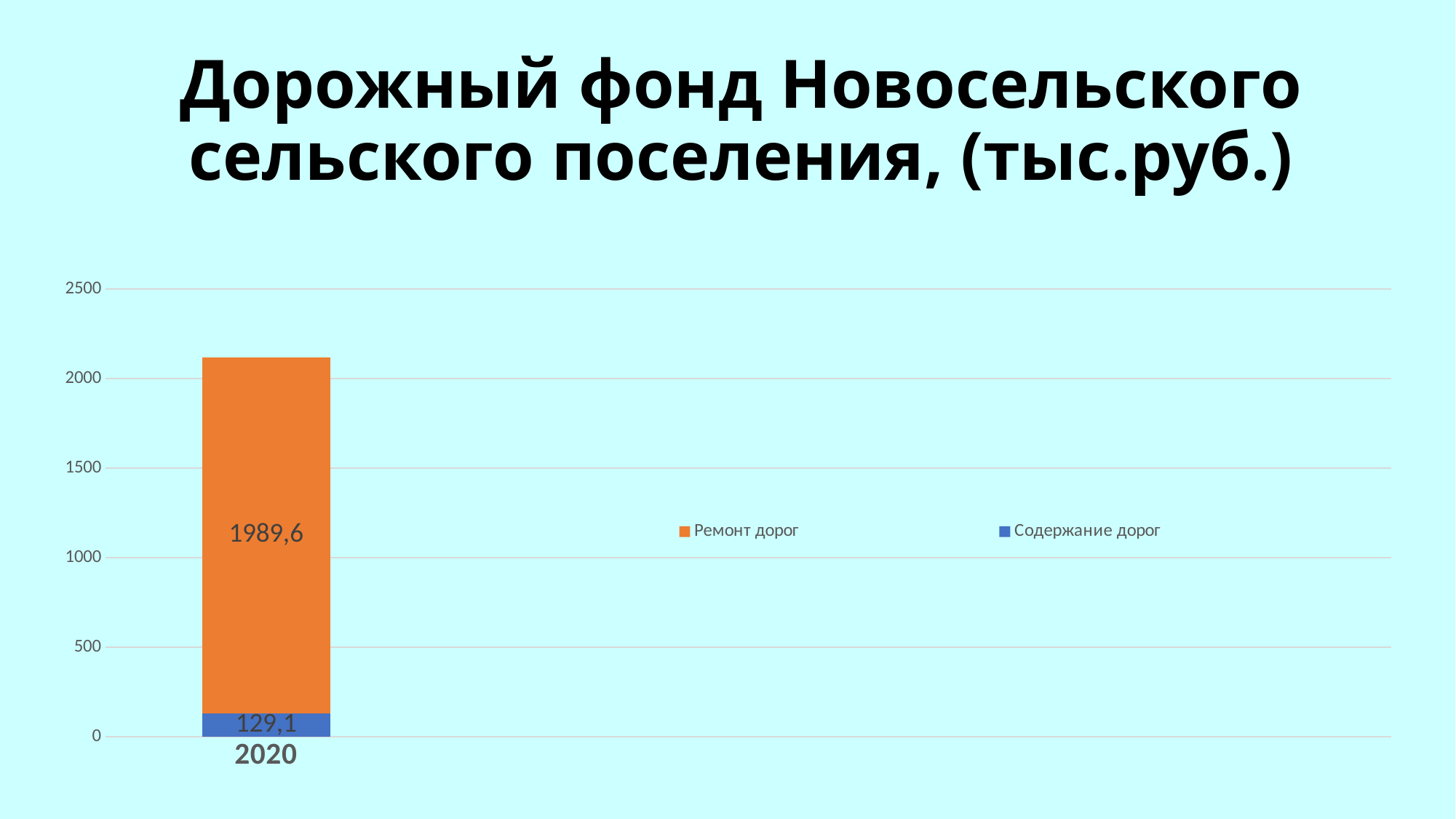
Is the total height of the 2020 stacked bar greater or less than 2000? greater What is the value for Содержание дорог in 2020? 129,1 Which series has the larger value in 2020, Ремонт дорог or Содержание дорог? Ремонт дорог Is the value for Содержание дорог in 2020 greater or less than 500? less What is the total of the stacked bar for 2020? 2118,7 What is the value for Ремонт дорог in 2020? 1989,6 What is the difference between the Ремонт дорог and Содержание дорог values in 2020? 1860,5 How many series does the legend list? 2 What kind of chart is shown on the slide? Stacked bar chart What is the title of the chart? Дорожный фонд Новосельского сельского поселения, (тыс.руб.) Which colour represents Содержание дорог in the chart? Blue How many categories are shown on the x axis? 1